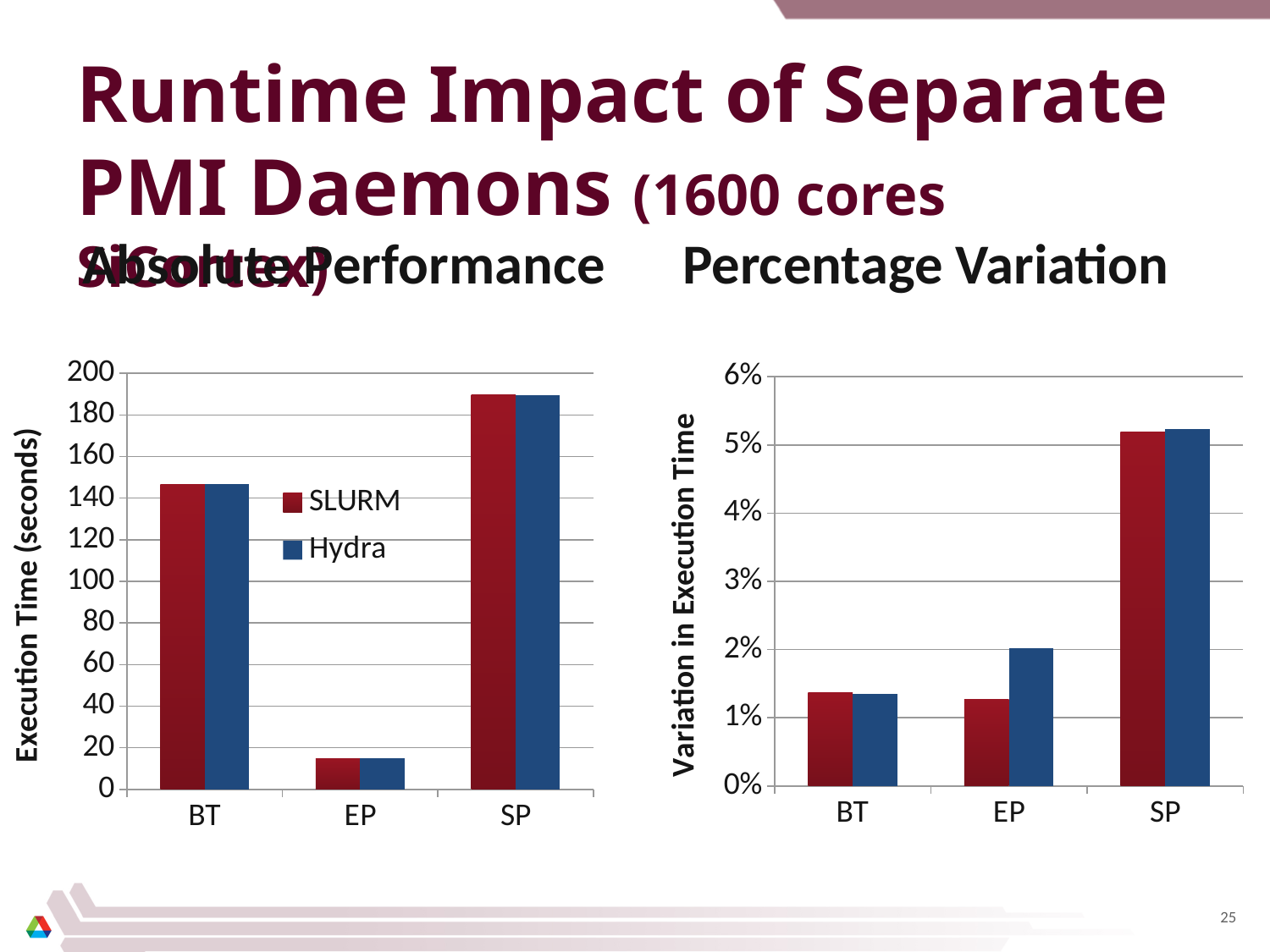
In the Absolute Performance chart, is the Hydra value for EP greater or less than 40? less In the Absolute Performance chart, is the SLURM value for BT greater or less than 120? greater What are the two series named in the legend of the Absolute Performance chart? SLURM and Hydra In the Percentage Variation chart, which category has the highest variation in execution time? SP How many categories are shown on the x axis of the Absolute Performance chart? 3 In the Percentage Variation chart, for EP, which is larger: the SLURM bar or the Hydra bar? Hydra What kind of chart is the Absolute Performance chart on the left? bar chart In the Absolute Performance chart, which category has the lowest execution time? EP How many series does the legend of the Absolute Performance chart list? 2 In the Percentage Variation chart, is the SLURM value for SP greater or less than 4%? greater What is the y-axis label of the Absolute Performance chart? Execution Time (seconds) In the Absolute Performance chart, which category has the highest execution time? SP